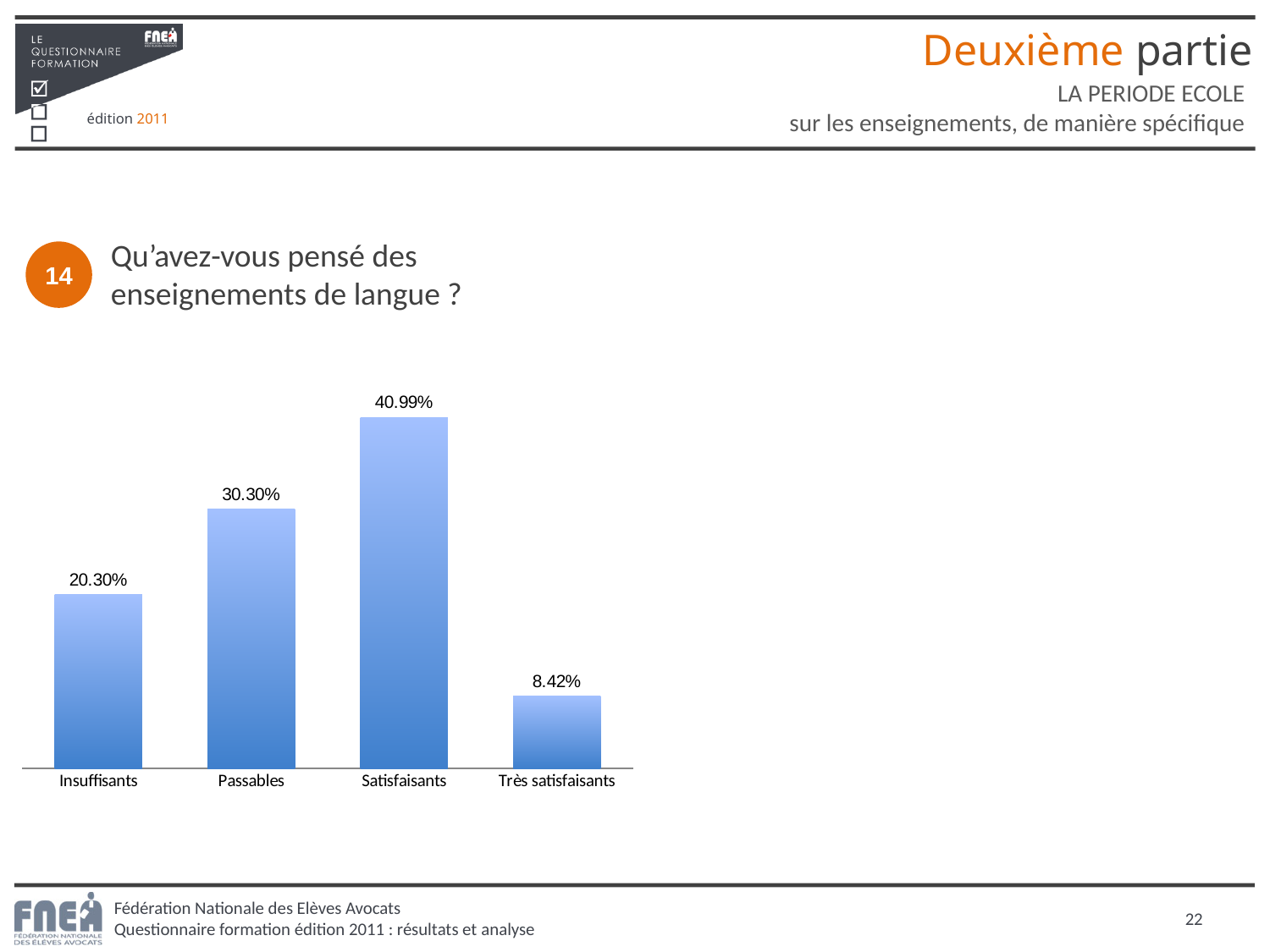
What is the difference between the values for Insuffisants and Très satisfaisants? 11.88% What is the value for Passables? 30.30% What question does the chart on the slide answer? Qu'avez-vous pensé des enseignements de langue ? What is the difference between the values for Satisfaisants and Passables? 10.69% What is the value for Insuffisants? 20.30% What is the value for Satisfaisants? 40.99% Which category has the lowest value? Très satisfaisants What kind of chart is shown on the slide? Bar chart How many categories are shown in the chart? 4 Which category has the highest value? Satisfaisants What is the value for Très satisfaisants? 8.42% Which is larger, the value for Insuffisants or the value for Passables? Passables